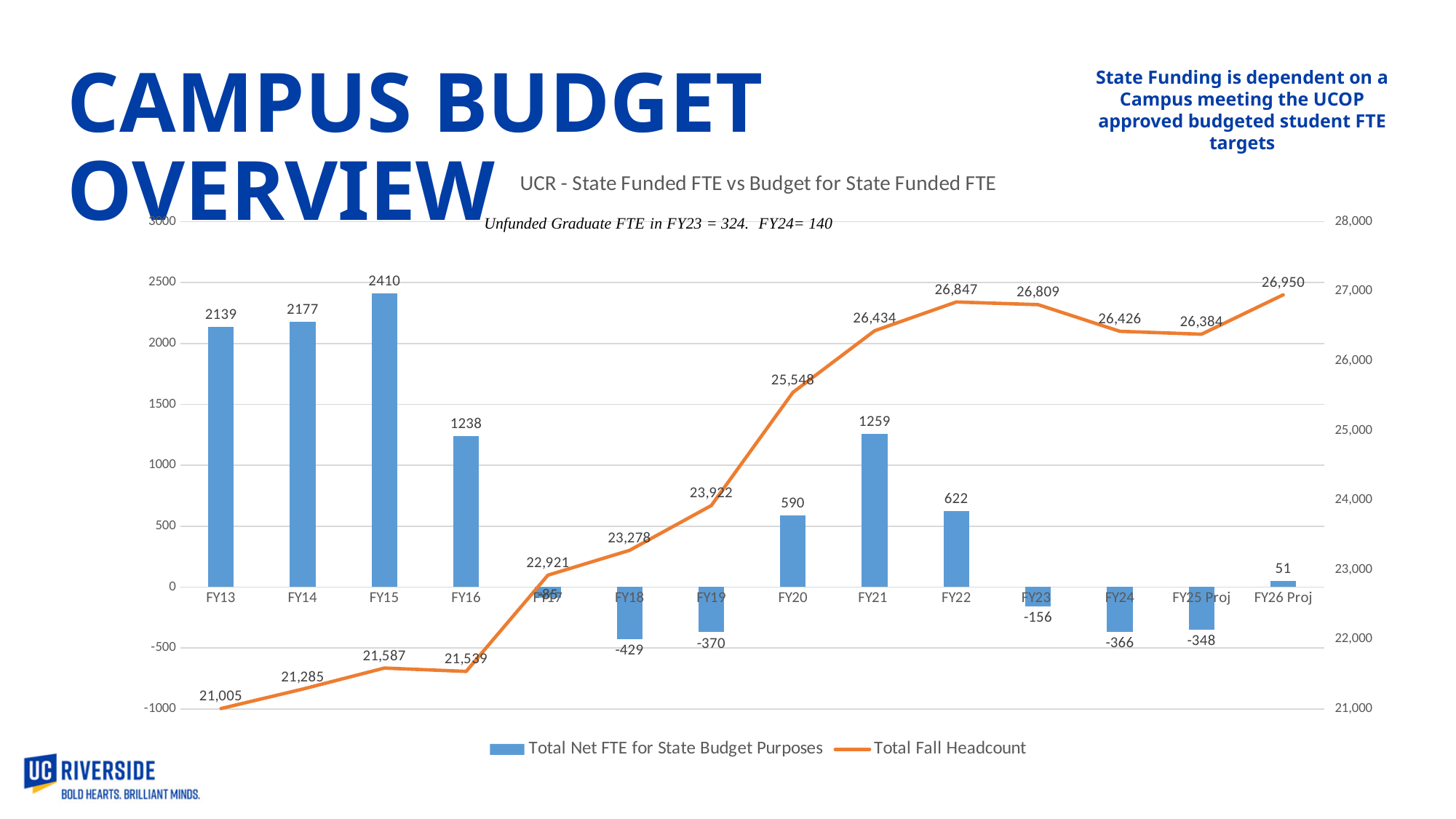
What kind of chart is this? Combined bar and line chart Which is larger, the Total Net FTE for State Budget Purposes in FY21 or in FY22? FY21 How many series does the legend list? 2 Which fiscal year has the highest Total Fall Headcount? FY26 Proj What is the Total Net FTE for State Budget Purposes in FY24? -366 Which fiscal year has the lowest Total Net FTE for State Budget Purposes? FY18 What is the difference in Total Fall Headcount between FY22 and FY13? 5,842 What is the title of the chart? UCR - State Funded FTE vs Budget for State Funded FTE How many fiscal years are shown on the x axis? 14 Which fiscal year has the highest Total Net FTE for State Budget Purposes? FY15 What is the Total Fall Headcount in FY20? 25,548 What is the Total Net FTE for State Budget Purposes in FY15? 2410